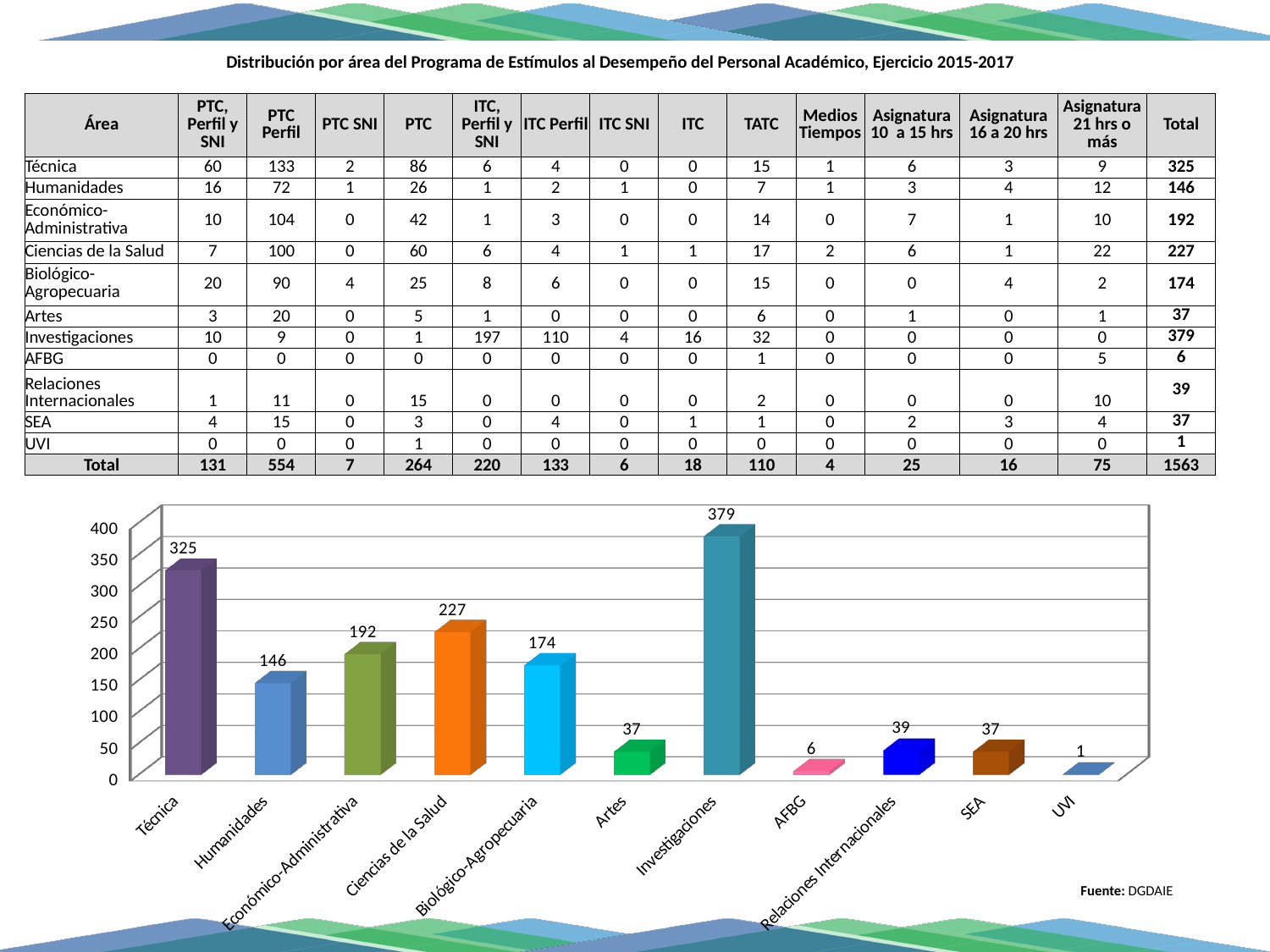
Which area has the highest value in the bar chart? Investigaciones What is the value shown for Ciencias de la Salud in the bar chart? 227 What is the difference between the values for Técnica and Humanidades in the bar chart? 179 Which is larger in the bar chart, Económico-Administrativa or Biológico-Agropecuaria? Económico-Administrativa What kind of chart is shown on the slide? bar chart What is the value shown for Investigaciones in the bar chart? 379 What is the value shown for Relaciones Internacionales in the bar chart? 39 What is the value shown for AFBG in the bar chart? 6 Is the value for Ciencias de la Salud in the bar chart greater or less than 200? greater Which area has the lowest value in the bar chart? UVI What is the difference between the values for Investigaciones and Técnica in the bar chart? 54 How many areas are plotted in the bar chart? 11